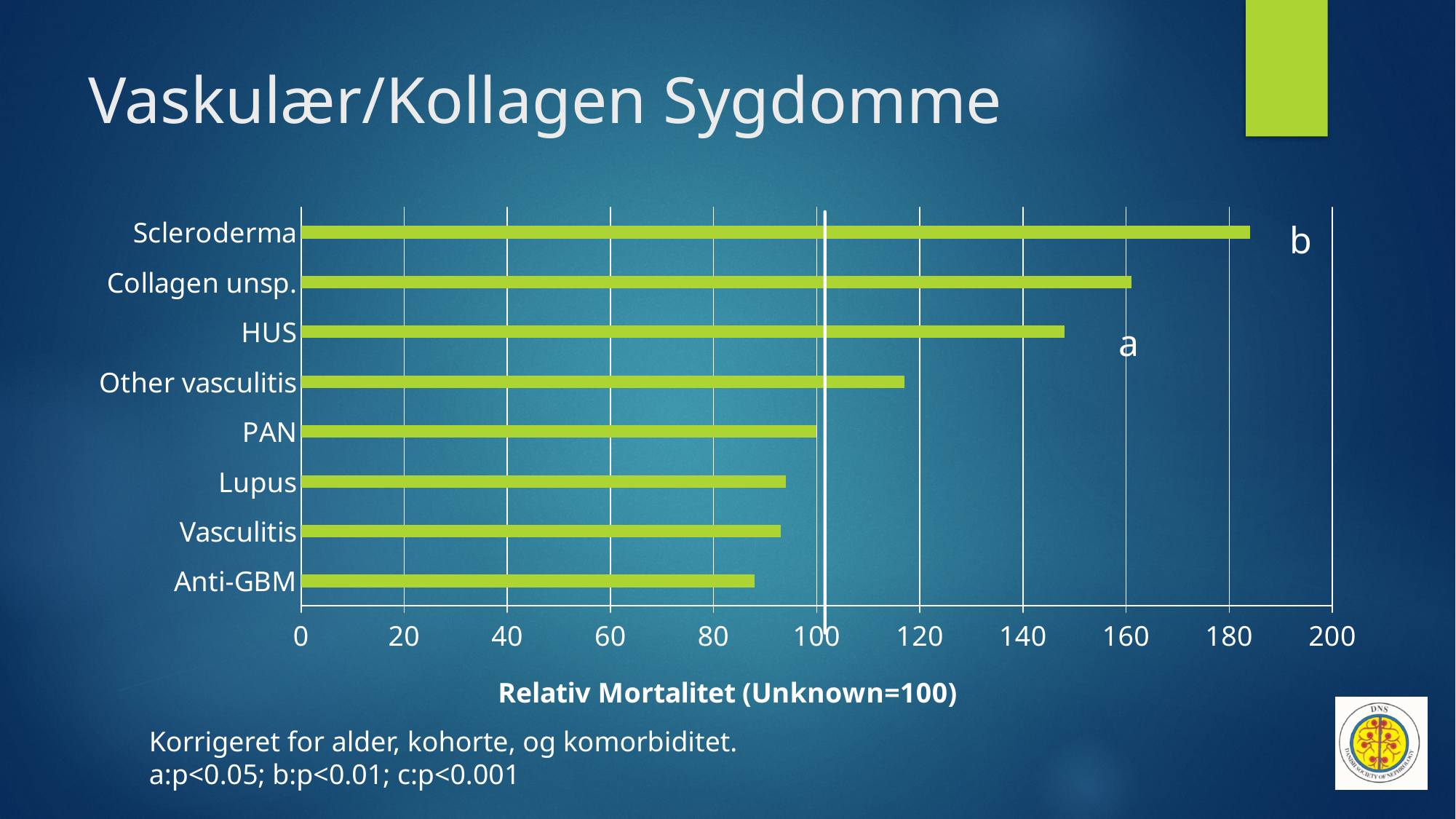
Is the value for Collagen unsp. greater or less than 140? greater Which category has the highest relative mortality? Scleroderma What is the title of the horizontal axis? Relativ Mortalitet (Unknown=100) Is the value for Other vasculitis greater or less than 100? greater Is the value for Scleroderma greater or less than 160? greater How many categories are plotted in the chart? 8 Which has a higher relative mortality, HUS or Lupus? HUS What kind of chart is shown on the slide? bar chart Which has a higher relative mortality, Scleroderma or Collagen unsp.? Scleroderma Which category has the lowest relative mortality? Anti-GBM